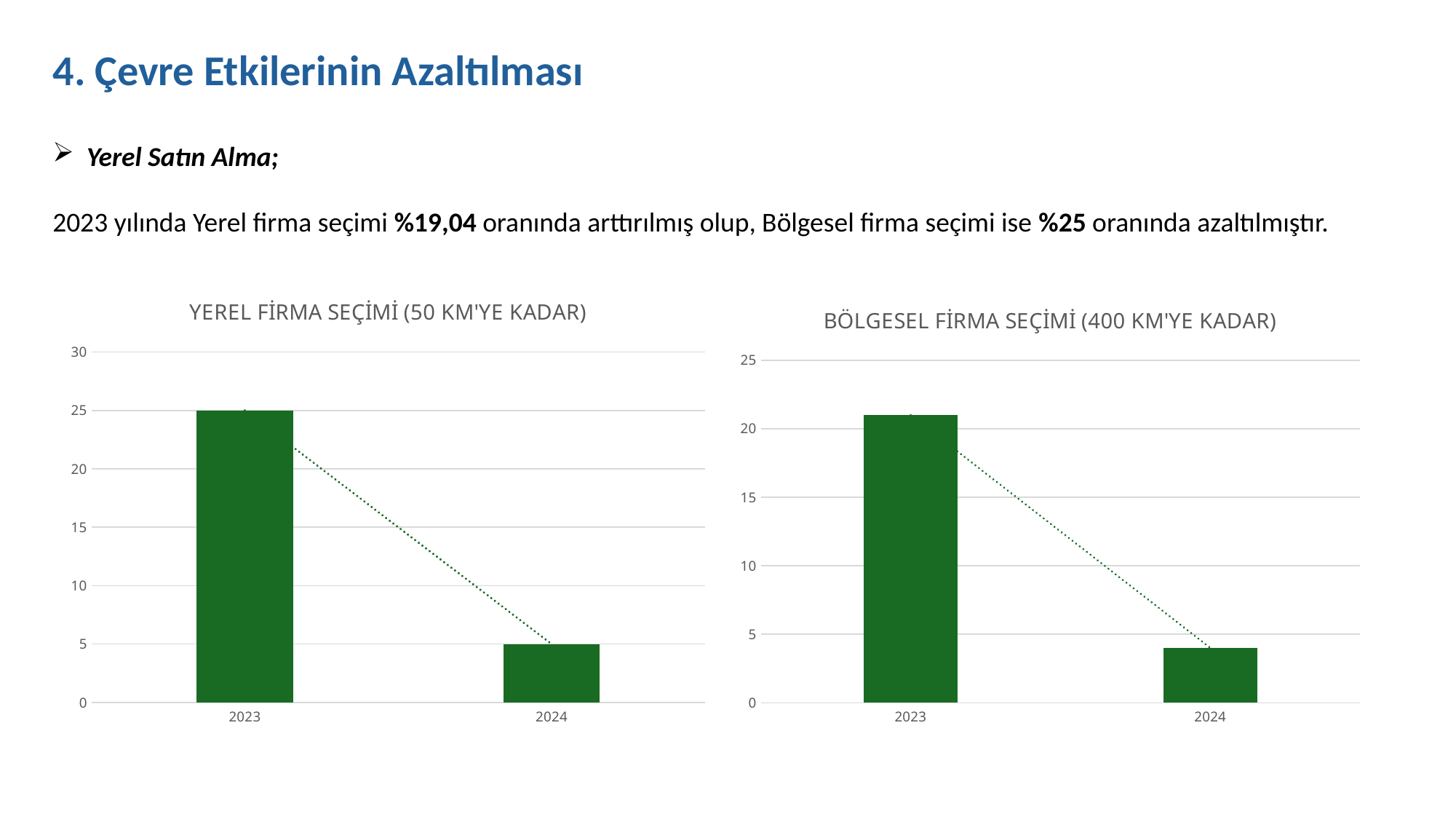
In the 'BÖLGESEL FİRMA SEÇİMİ (400 KM'YE KADAR)' chart, is the value for 2023 greater or less than 20? greater In the 'BÖLGESEL FİRMA SEÇİMİ (400 KM'YE KADAR)' chart, which is larger, the value for 2023 or 2024? 2023 In the 'YEREL FİRMA SEÇİMİ (50 KM'YE KADAR)' chart, what is the value for 2023? 25 In the 'YEREL FİRMA SEÇİMİ (50 KM'YE KADAR)' chart, which year has the highest value? 2023 What kind of chart is the 'YEREL FİRMA SEÇİMİ (50 KM'YE KADAR)' chart? bar chart In the 'YEREL FİRMA SEÇİMİ (50 KM'YE KADAR)' chart, do the values rise or fall from 2023 to 2024? fall In the 'YEREL FİRMA SEÇİMİ (50 KM'YE KADAR)' chart, what is the difference between the 2023 and 2024 values? 20 What is the title of the chart on the right side of the slide? BÖLGESEL FİRMA SEÇİMİ (400 KM'YE KADAR) In the 'BÖLGESEL FİRMA SEÇİMİ (400 KM'YE KADAR)' chart, which year has the lowest value? 2024 How many categories are shown on the x axis of the 'BÖLGESEL FİRMA SEÇİMİ (400 KM'YE KADAR)' chart? 2 In the 'BÖLGESEL FİRMA SEÇİMİ (400 KM'YE KADAR)' chart, is the value for 2024 greater or less than 5? less In the 'YEREL FİRMA SEÇİMİ (50 KM'YE KADAR)' chart, what is the value for 2024? 5